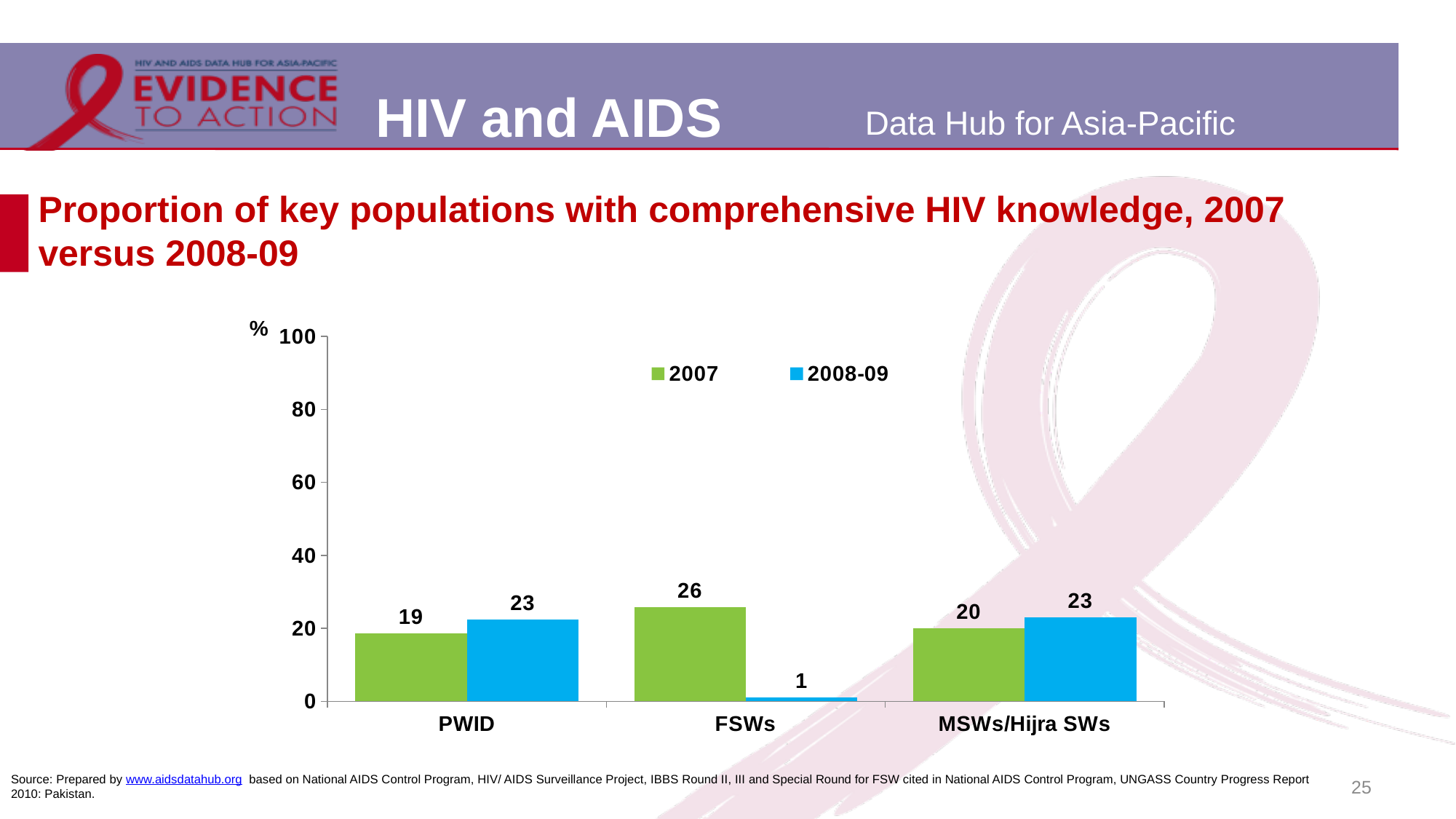
How many series does the legend list? 2 Which category has the highest value in 2007? FSWs What is the value for MSWs/Hijra SWs in 2008-09? 23 What is the difference between the 2007 and 2008-09 values for FSWs? 25 Which category has the lowest value in 2008-09? FSWs How many categories are shown on the x axis? 3 Is the value for FSWs in 2007 greater or less than 40? less What is the value for PWID in 2007? 19 What is the value for FSWs in 2008-09? 1 What is the difference between the 2008-09 and 2007 values for PWID? 4 Which is larger for MSWs/Hijra SWs, the 2007 value or the 2008-09 value? 2008-09 What kind of chart is shown on the slide? bar chart